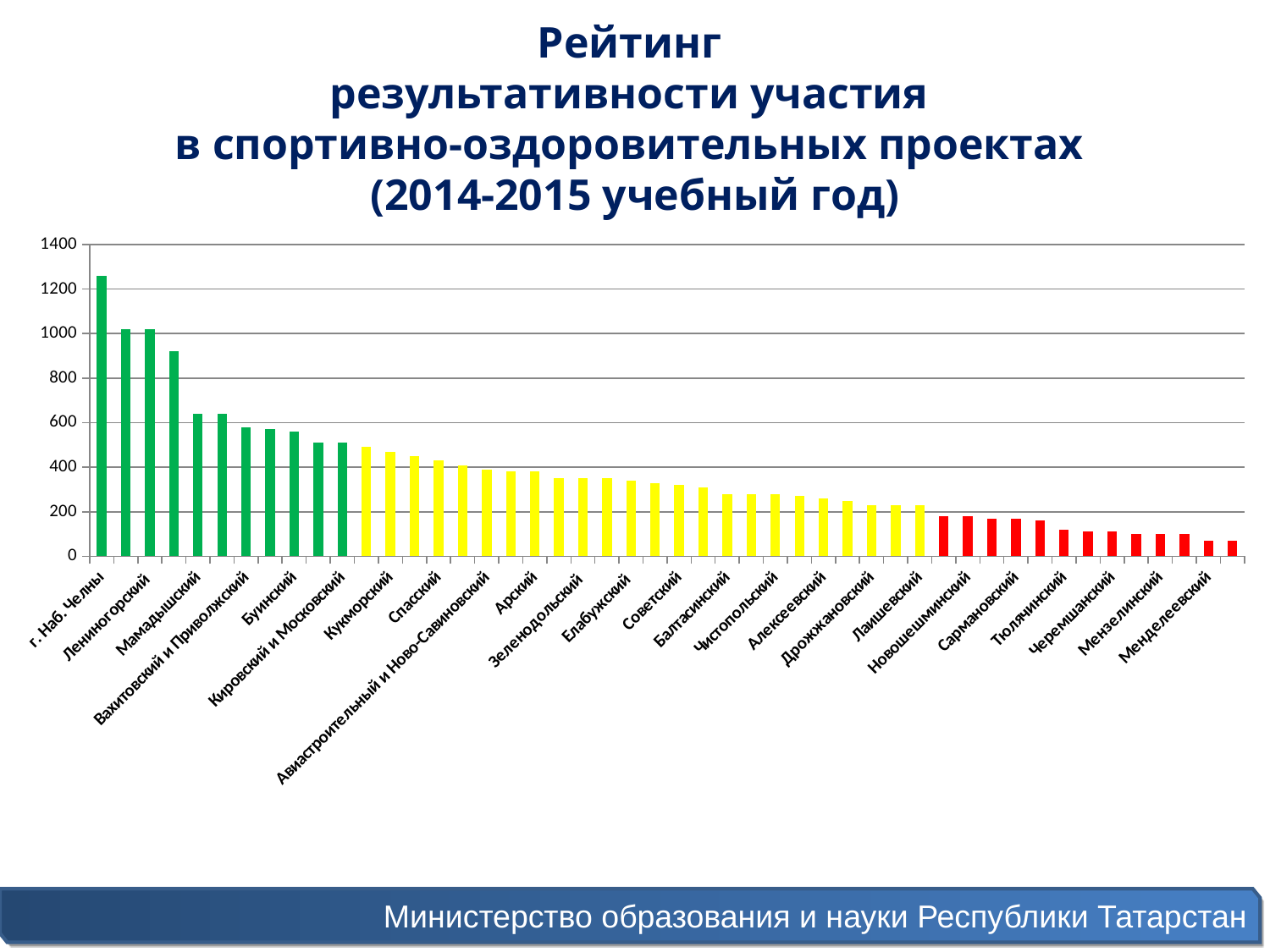
How many different bar colours are used in the chart? 3 Is the value for Лениногорский greater or less than 800? greater Do the values rise or fall moving from left to right along the x axis? fall Is the value for Арский greater or less than 600? less Is the value for г. Наб. Челны greater or less than 1000? greater What is the highest value shown on the vertical axis? 1400 Which is larger, the value for Лениногорский or the value for Кукморский? Лениногорский What kind of chart is shown on the slide? bar chart Which category has the highest value in the chart? г. Наб. Челны